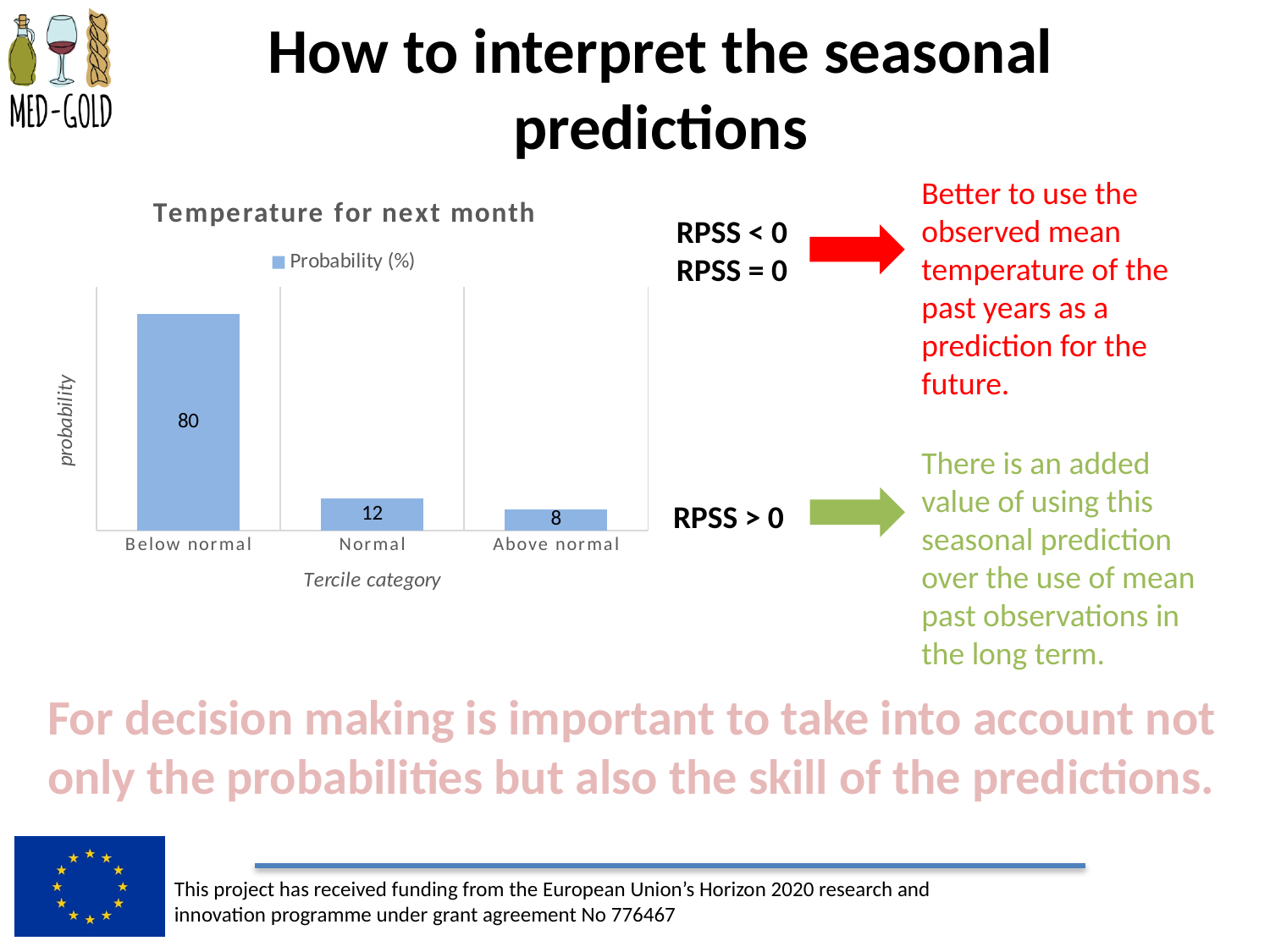
What kind of chart is shown on the slide? Bar chart Which has a larger probability, Normal or Above normal? Normal How many tercile categories are shown in the chart? 3 What is the probability value for the Normal tercile category? 12 Which tercile category has the highest probability? Below normal What is the probability value for the Below normal tercile category? 80 What is the title of the chart? Temperature for next month What is the difference between the probability for Normal and the probability for Above normal? 4 How many series does the chart legend list? 1 What is the probability value for the Above normal tercile category? 8 What is the difference between the probability for Below normal and the probability for Normal? 68 Which tercile category has the lowest probability? Above normal